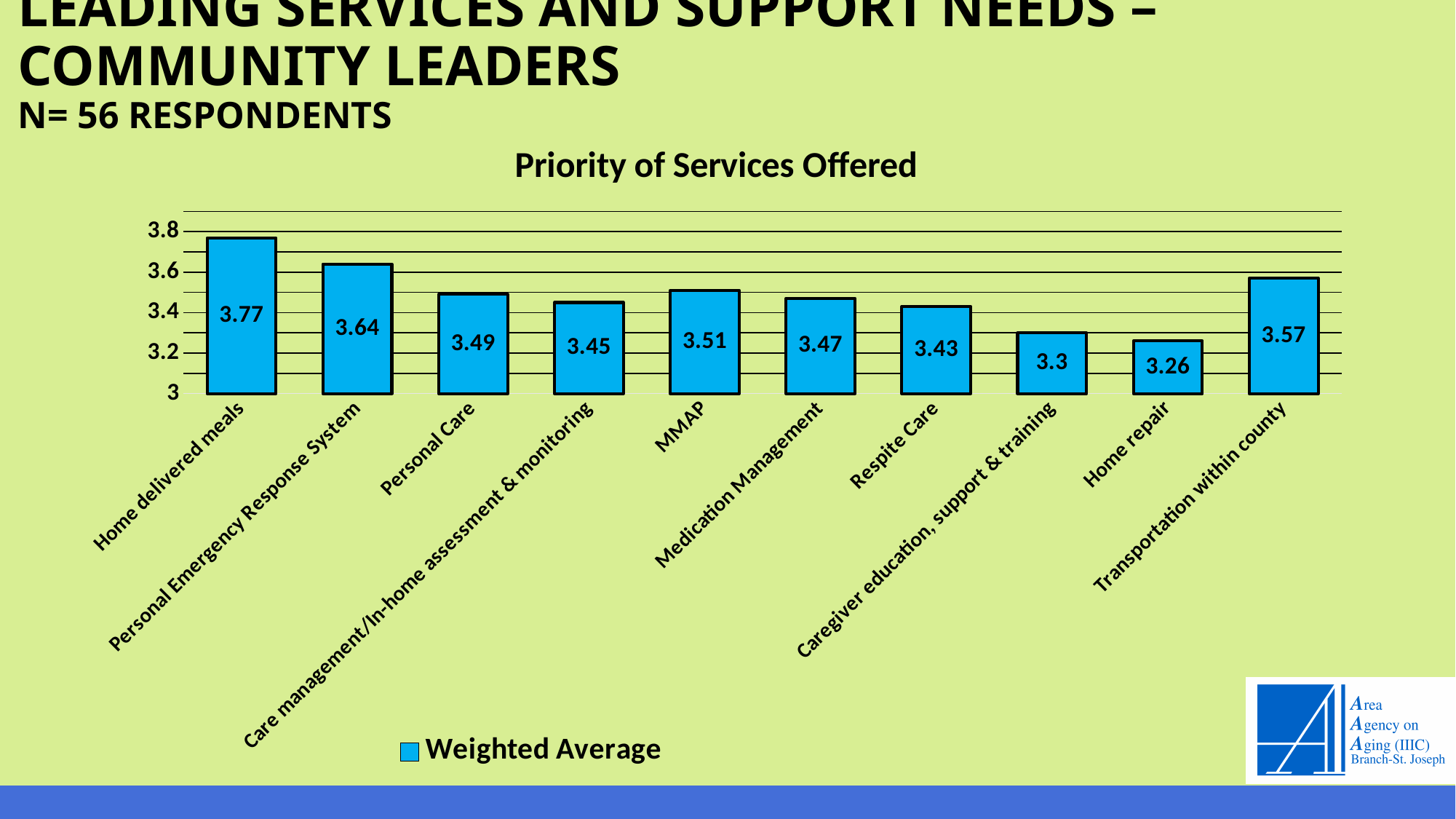
What is the weighted average for Transportation within county? 3.57 What is the weighted average for Home repair? 3.26 What is the weighted average for Caregiver education, support & training? 3.3 How many series does the legend list? 1 Which has a higher weighted average, MMAP or Respite Care? MMAP What is the title of the chart? Priority of Services Offered What is the difference between the weighted averages for Home delivered meals and Home repair? 0.51 What type of chart is shown on the slide? Bar chart Which service has the lowest weighted average? Home repair What is the weighted average for Home delivered meals? 3.77 How many services are shown in the chart? 10 Which service has the highest weighted average? Home delivered meals